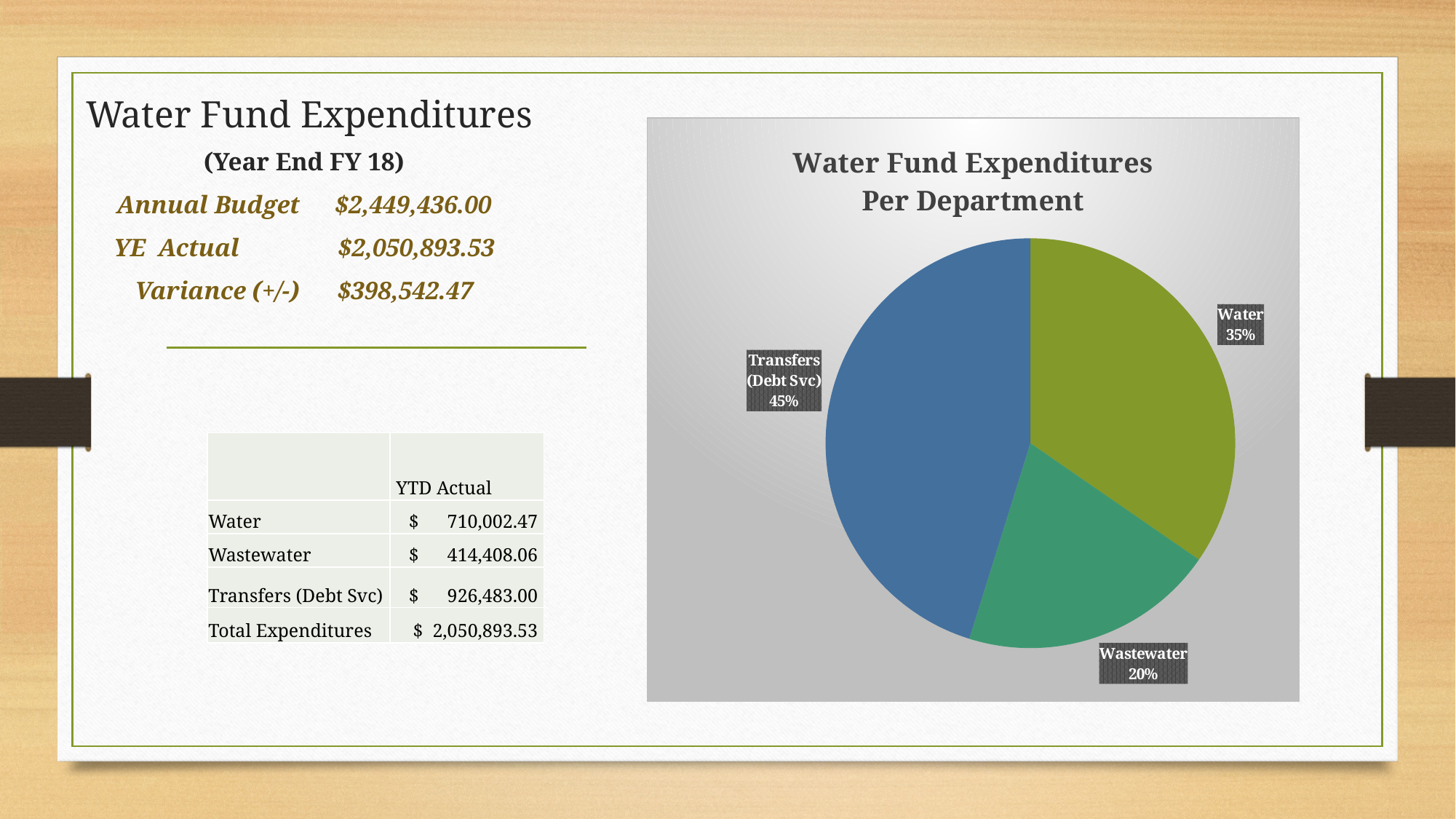
What kind of chart is shown on the slide? pie chart What is the difference in percentage points between the Water slice and the Wastewater slice? 15% What share of the pie does Wastewater represent? 20% What colour is the Transfers (Debt Svc) slice? blue What share of the pie does Water represent? 35% Which slice is larger, Water or Wastewater? Water Which department has the smallest slice of the pie? Wastewater What is the title of the chart? Water Fund Expenditures Per Department Which department has the largest slice of the pie? Transfers (Debt Svc) What share of the pie does Transfers (Debt Svc) represent? 45% How many slices does the pie chart have? 3 What is the difference in percentage points between the Transfers (Debt Svc) slice and the Water slice? 10%